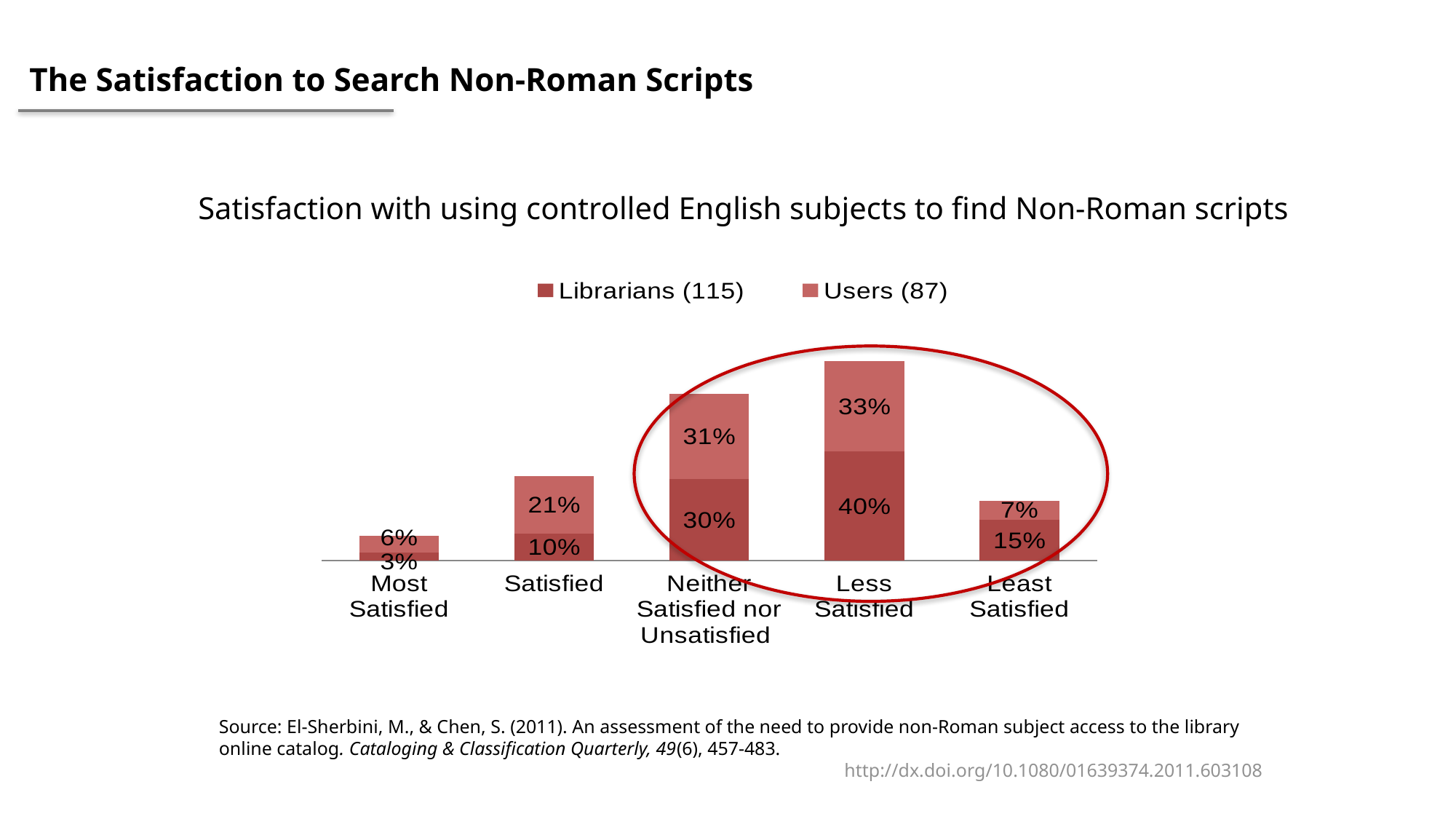
What percentage of Librarians are Most Satisfied? 3% What percentage of Users are Least Satisfied? 7% What is the difference between the Librarians and Users values for Least Satisfied? 8% How many series does the legend list? 2 What percentage of Users are Satisfied? 21% What kind of chart is shown on the slide? Stacked bar chart What is the total of the stacked bar for Less Satisfied? 73% Which is larger for the Satisfied category, the Librarians value or the Users value? Users What percentage of Librarians are Less Satisfied? 40% Which category has the lowest value for Users? Most Satisfied Which category has the highest value for Librarians? Less Satisfied How many categories are shown on the x axis? 5